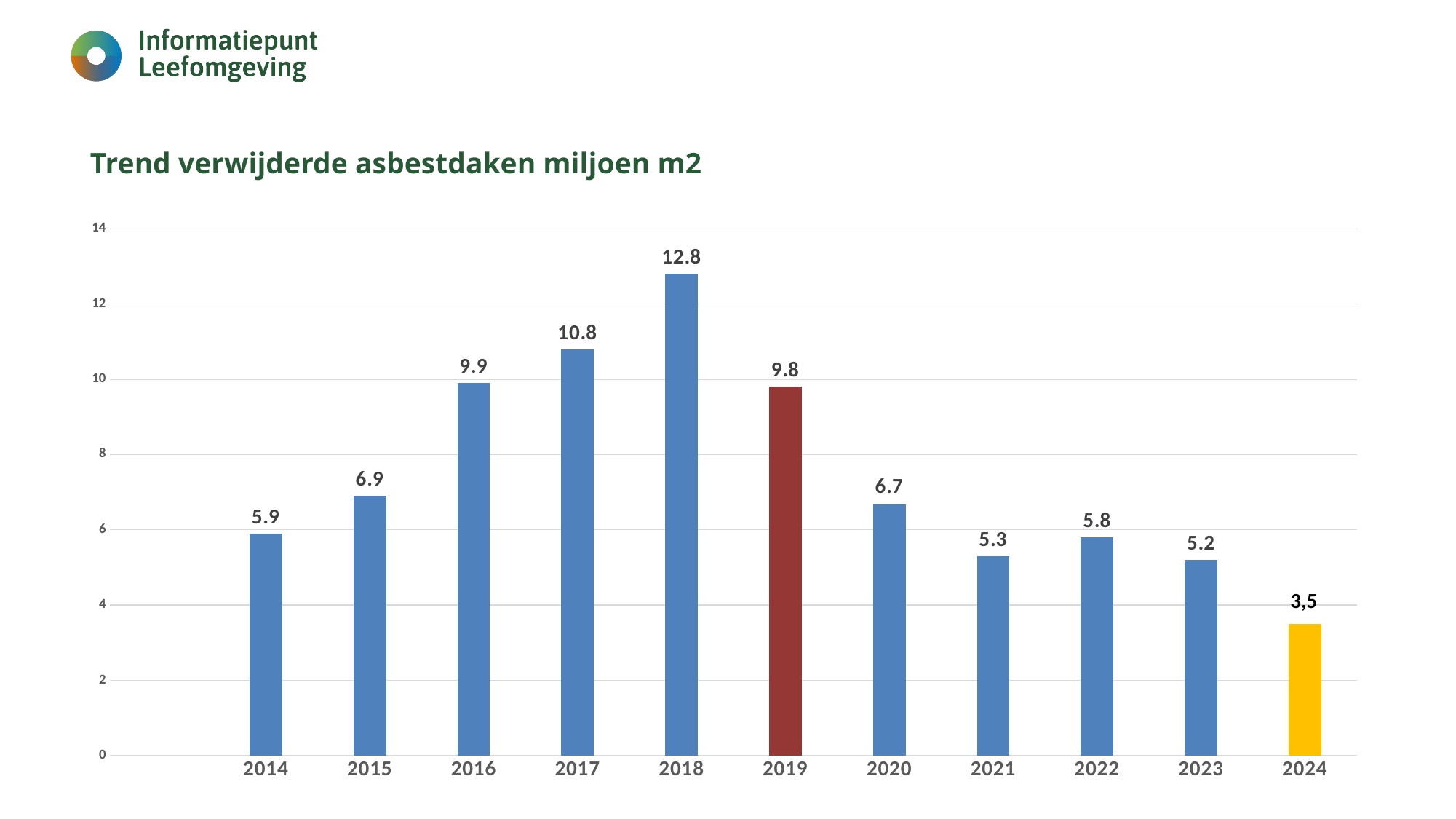
What is the title of the chart? Trend verwijderde asbestdaken miljoen m2 What is the value for 2019? 9.8 Do the values rise or fall from 2018 to 2021? fall What is the difference between the values for 2018 and 2017? 2.0 Is the value for 2016 greater or less than 8? greater What is the value for 2024? 3,5 What is the value for 2018? 12.8 Which year has the lowest value? 2024 How many years are shown on the x axis? 11 Which is larger, the value for 2015 or the value for 2020? 2015 What kind of chart is shown? bar chart Which year has the highest value? 2018